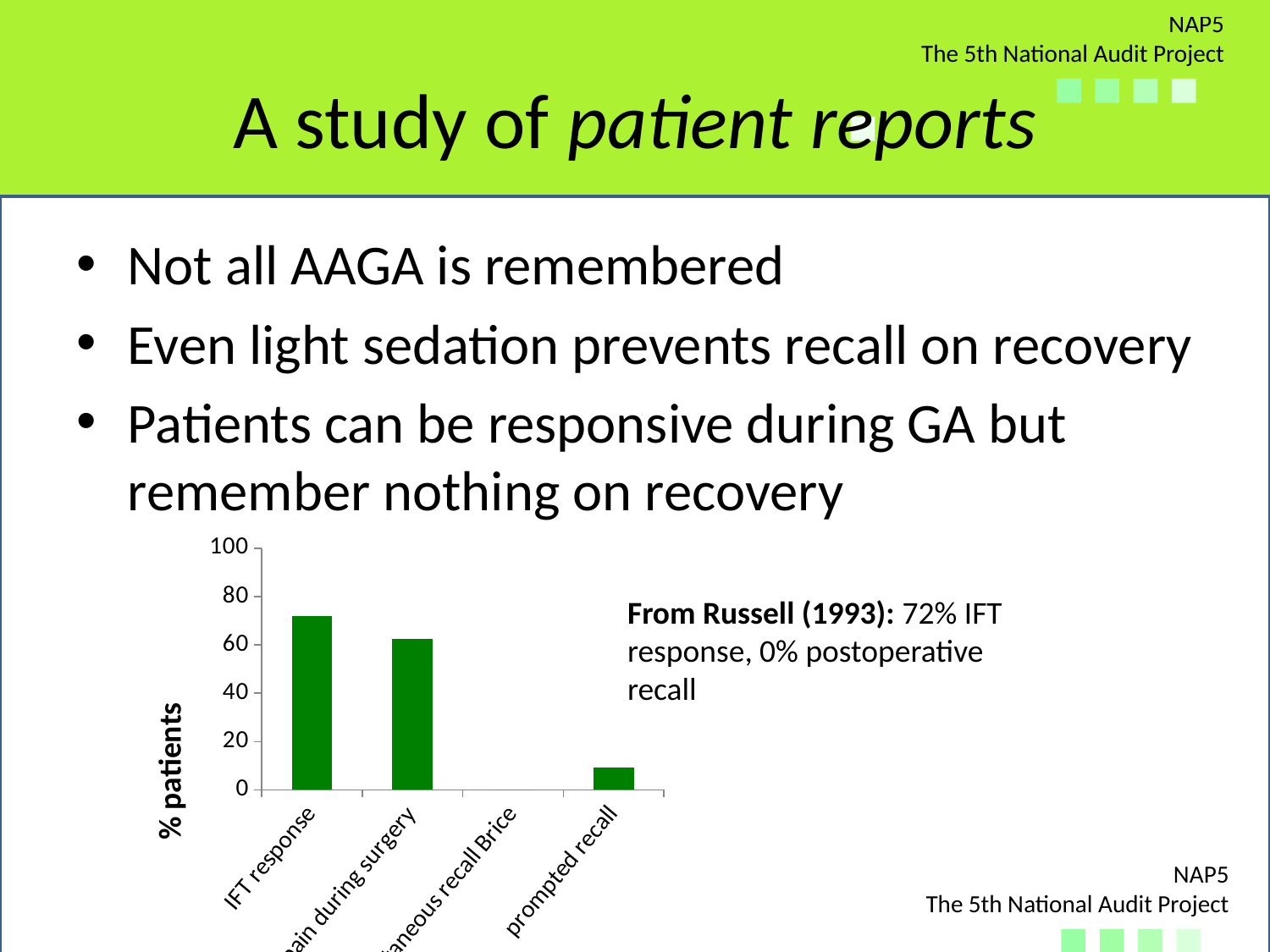
According to the slide, what percentage of patients showed an IFT response in Russell (1993)? 72% What is the highest tick value shown on the vertical axis of the chart? 100 What is the label of the vertical axis of the bar chart? % patients How many categories are plotted on the bar chart? 4 Is the value for IFT response greater or less than 60? greater Is the value for IFT response greater or less than 80? less Is the value for prompted recall greater or less than 20? less Which category has the highest bar on the chart? IFT response Which is larger, the value for IFT response or the value for prompted recall? IFT response What kind of chart is shown on the slide? bar chart Do the bar values generally rise or fall from left to right across the chart? fall